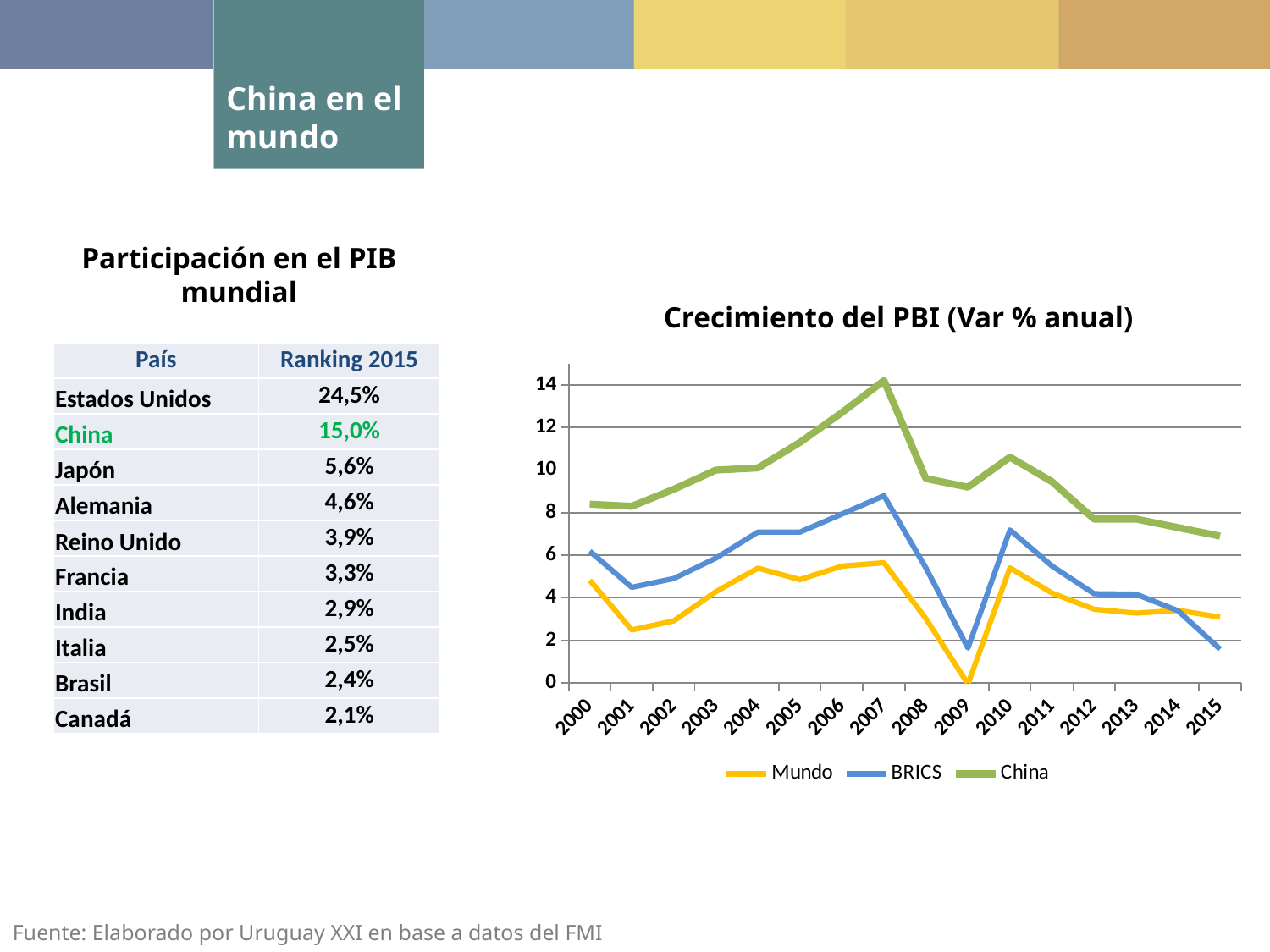
In the 'Crecimiento del PBI (Var % anual)' chart, which series has the larger value in 2007, China or Mundo? China In the 'Crecimiento del PBI (Var % anual)' chart, in which year does the Mundo series reach its lowest value? 2009 In the 'Crecimiento del PBI (Var % anual)' chart, is the value for BRICS in 2010 greater or less than 6? greater In the 'Crecimiento del PBI (Var % anual)' chart, is the value for Mundo in 2009 greater or less than 2? less In the 'Crecimiento del PBI (Var % anual)' chart, does the China series rise or fall from 2010 to 2015? Fall In the 'Crecimiento del PBI (Var % anual)' chart, in which year does the China series reach its highest value? 2007 How many years are shown on the x axis of the 'Crecimiento del PBI (Var % anual)' chart? 16 In the 'Crecimiento del PBI (Var % anual)' chart, is the value for China in 2007 greater or less than 12? greater How many series does the legend of the 'Crecimiento del PBI (Var % anual)' chart list? 3 In the 'Crecimiento del PBI (Var % anual)' chart, which series is drawn in green? China What kind of chart is 'Crecimiento del PBI (Var % anual)'? Line chart In the 'Crecimiento del PBI (Var % anual)' chart, which series has the larger value in 2010, BRICS or Mundo? BRICS